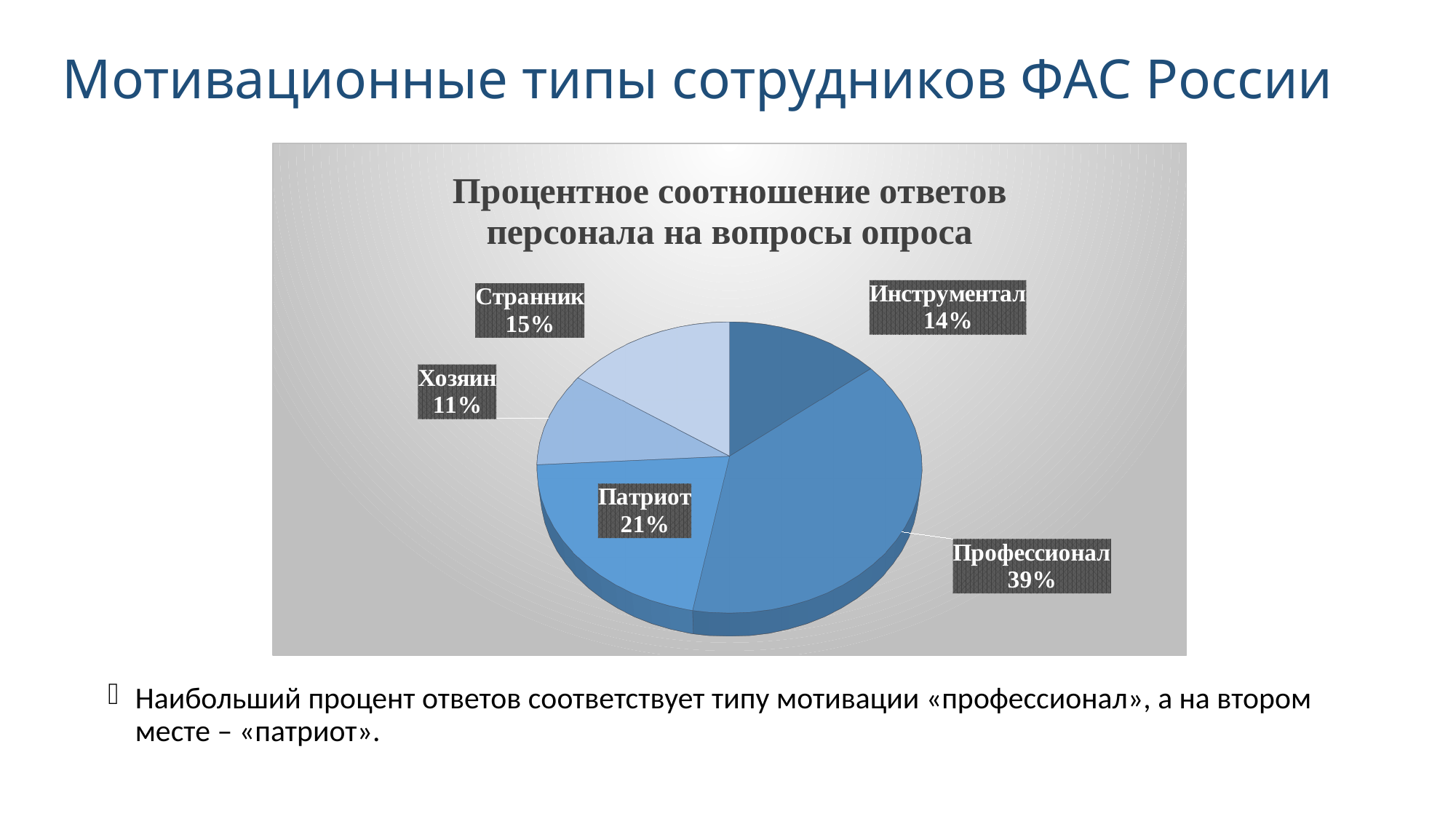
What type of chart is shown on the slide? Pie chart What is the difference in percentage points between 'Профессионал' and 'Патриот'? 18 Which motivational type has the smallest share of responses? Хозяин What is the title of the chart? Процентное соотношение ответов персонала на вопросы опроса What percentage of responses corresponds to the 'Патриот' type? 21% What percentage of responses corresponds to the 'Хозяин' type? 11% What percentage of responses corresponds to the 'Профессионал' type? 39% How many motivational types are shown in the pie chart? 5 Which has a larger share, 'Странник' or 'Инструментал'? Странник Which motivational type has the largest share of responses? Профессионал What percentage of responses corresponds to the 'Инструментал' type? 14% What percentage of responses corresponds to the 'Странник' type? 15%